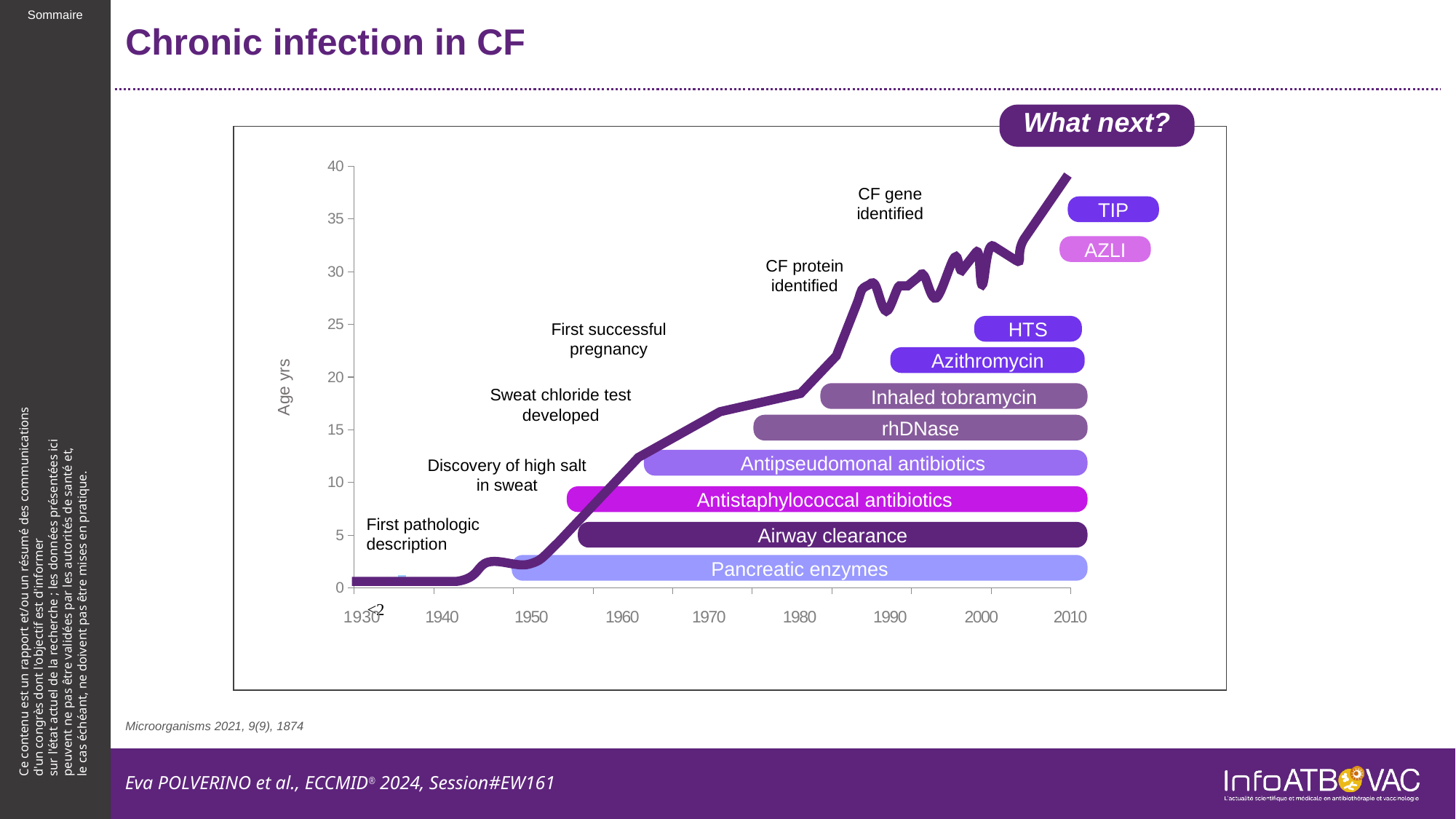
Is the value of the line at 1960 greater or less than 5? greater What is the label of the vertical axis? Age yrs How many year labels are shown along the horizontal axis? 9 What is the first year shown on the horizontal axis? 1930 Is the value of the line at 1980 greater or less than 20? less Which year has the higher value on the line, 1950 or 2000? 2000 Is the value of the line at 1930 greater or less than 5? less What kind of chart is shown on the slide? line chart What value label is printed next to the start of the line near 1930? <2 Does the plotted line generally rise or fall from 1930 to 2010? rise